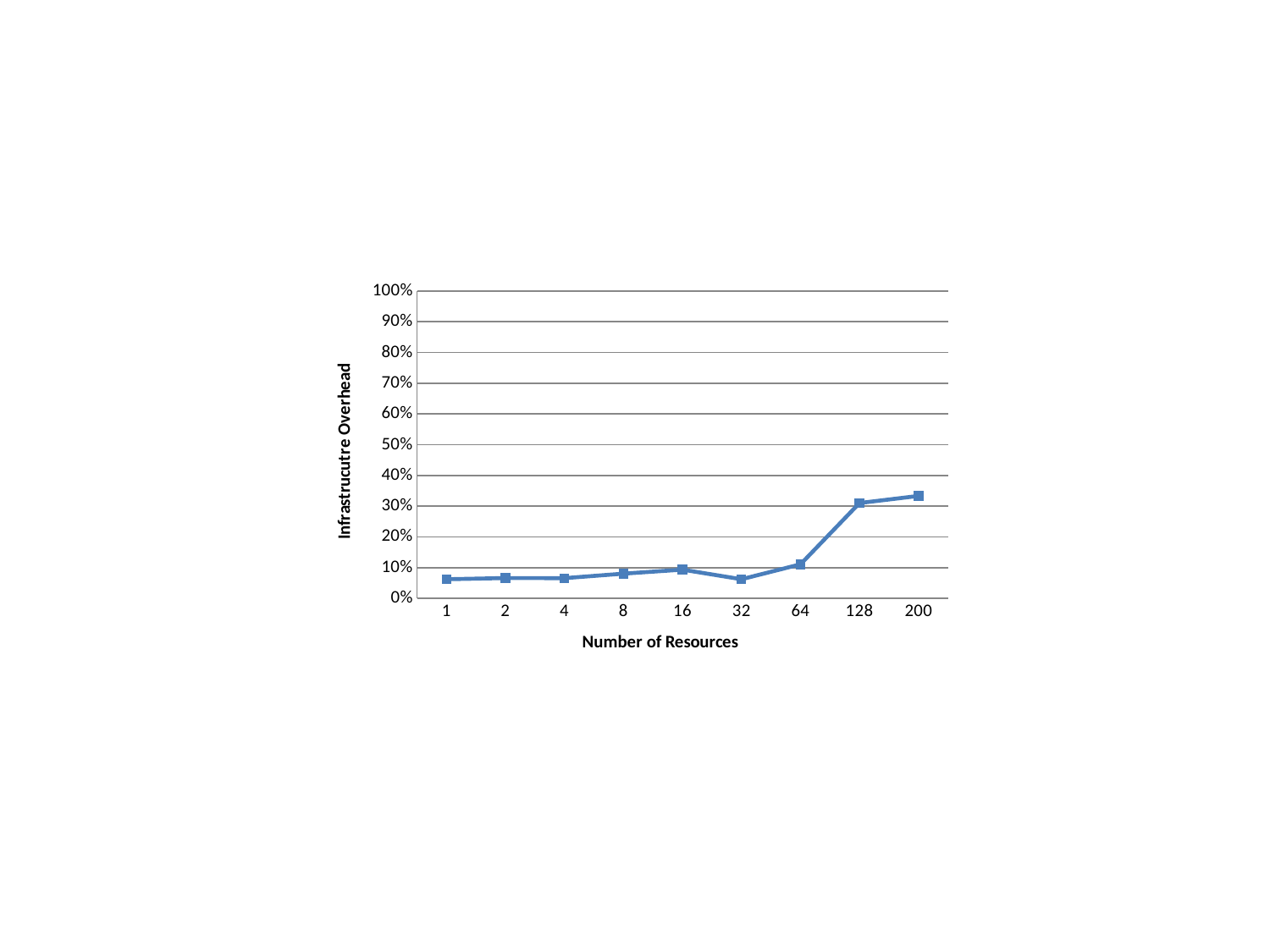
What kind of chart is shown on the slide? line chart How many data points are plotted on the line? 9 Does the infrastructure overhead generally rise or fall as the number of resources increases? rise Is the infrastructure overhead for 32 resources greater or less than 10%? less At which number of resources is the infrastructure overhead highest? 200 Which has a higher infrastructure overhead, 64 resources or 128 resources? 128 resources Is the infrastructure overhead for 1 resource greater or less than 10%? less What is the title of the x axis? Number of Resources Is the infrastructure overhead for 128 resources greater or less than 20%? greater